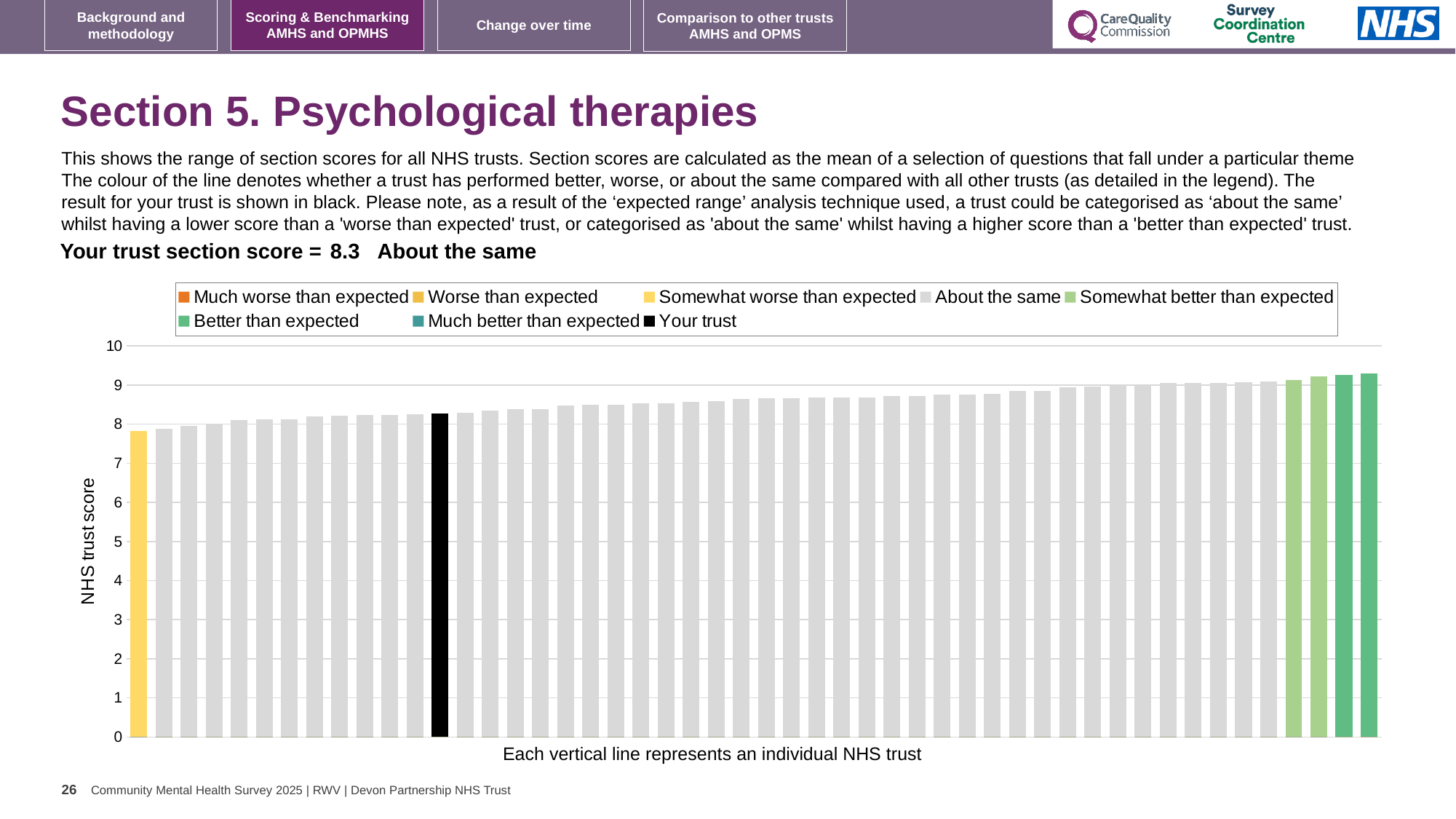
What type of chart is shown on the slide? bar chart What is the label on the vertical axis of the chart? NHS trust score How many entries does the chart legend list? 8 Which category is your trust placed in for this section? About the same Is the value of the black 'Your trust' bar greater or less than 8? greater Is the value of the leftmost (yellow) bar greater or less than 8? less Do the bar values rise or fall from left to right along the x axis? rise Which legend category does the highest-scoring trust belong to? Better than expected What is the section score for your trust shown on the slide? 8.3 Is the value of the rightmost bar greater or less than 9? greater How many bars are coloured as 'Better than expected'? 2 How many bars are coloured as 'Somewhat worse than expected'? 1